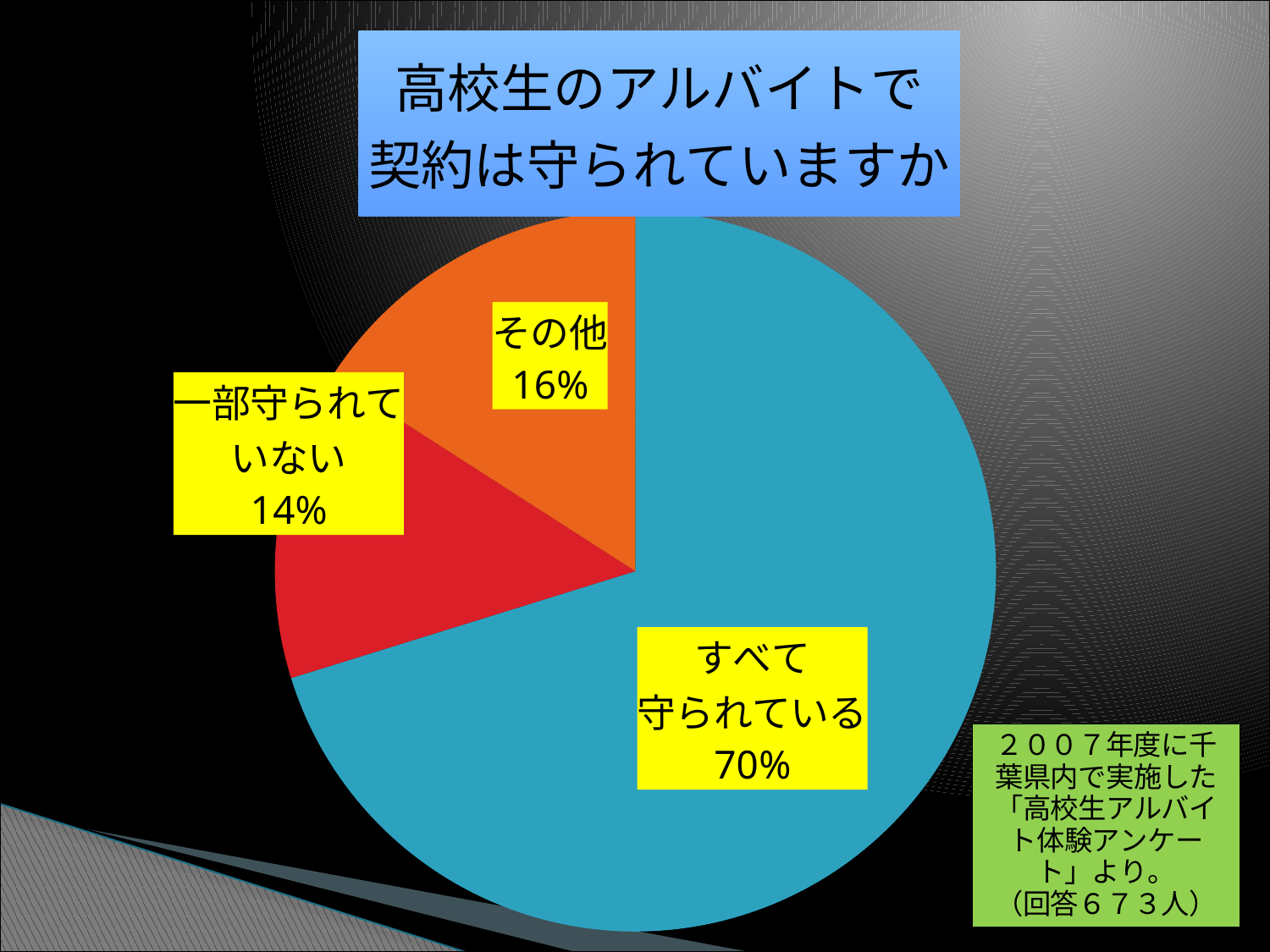
What kind of chart is shown on the slide? pie chart What percentage is shown for 一部守られていない? 14% How many slices does the pie chart have? 3 Which is larger, the slice for その他 or the slice for 一部守られていない? その他 What is the difference in percentage points between その他 and 一部守られていない? 2 Which category has the largest slice of the pie? すべて守られている What is the title of the chart? 高校生のアルバイトで契約は守られていますか What is the difference in percentage points between すべて守られている and その他? 54 What percentage is shown for その他? 16% What percentage is shown for すべて守られている? 70% Which category has the smallest slice of the pie? 一部守られていない What colour is the slice for すべて守られている? blue